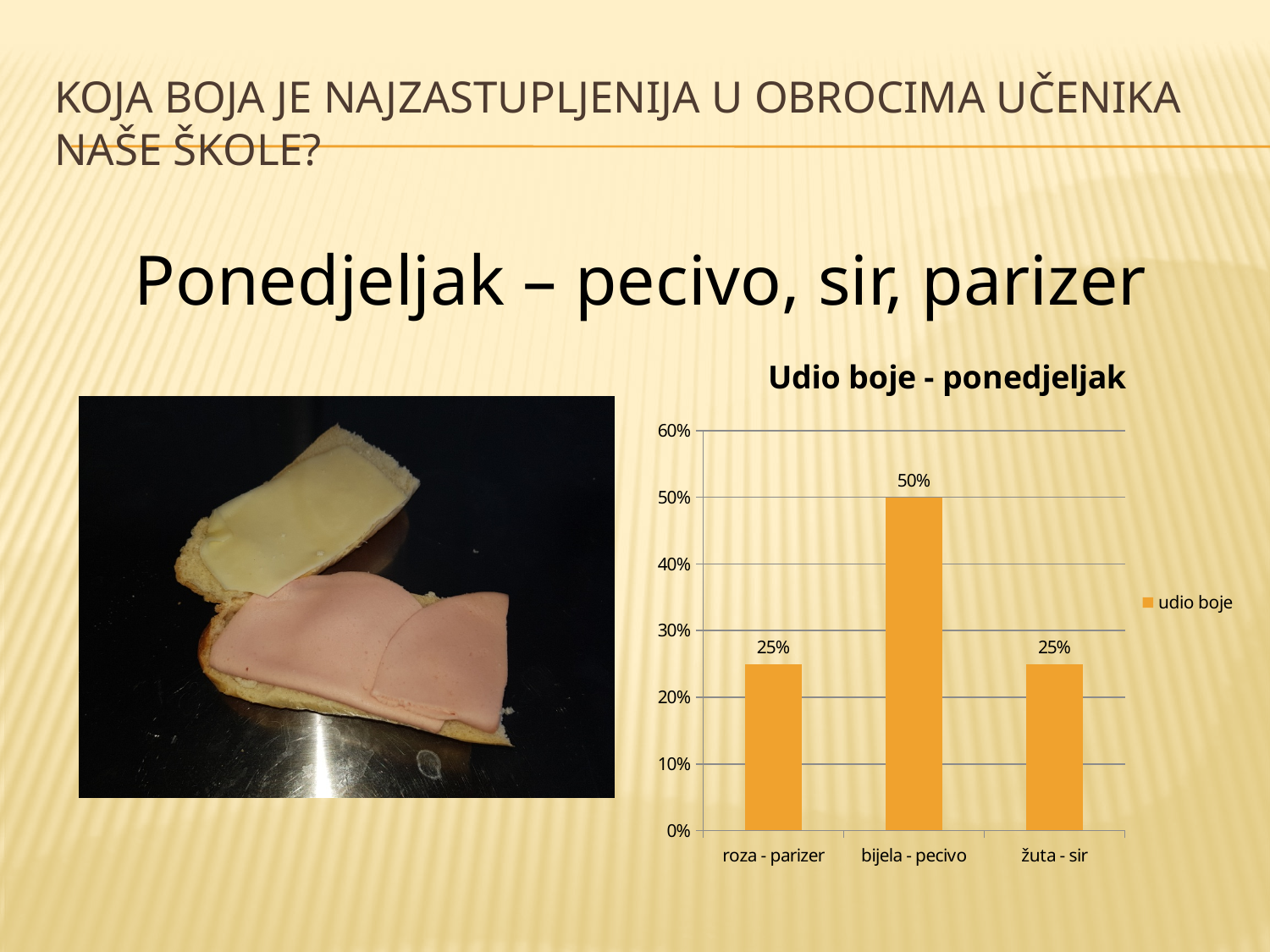
What is the value for roza - parizer? 25% Which is larger, the value for bijela - pecivo or the value for žuta - sir? bijela - pecivo What is the title of the chart? Udio boje - ponedjeljak Is the value for bijela - pecivo greater or less than 40%? greater What is the value for bijela - pecivo? 50% What is the value for žuta - sir? 25% Which category has the highest value? bijela - pecivo What kind of chart is shown? bar chart What is the difference between the values for bijela - pecivo and roza - parizer? 25% Is the value for roza - parizer greater or less than 30%? less How many series does the legend list? 1 How many categories are shown on the x axis? 3